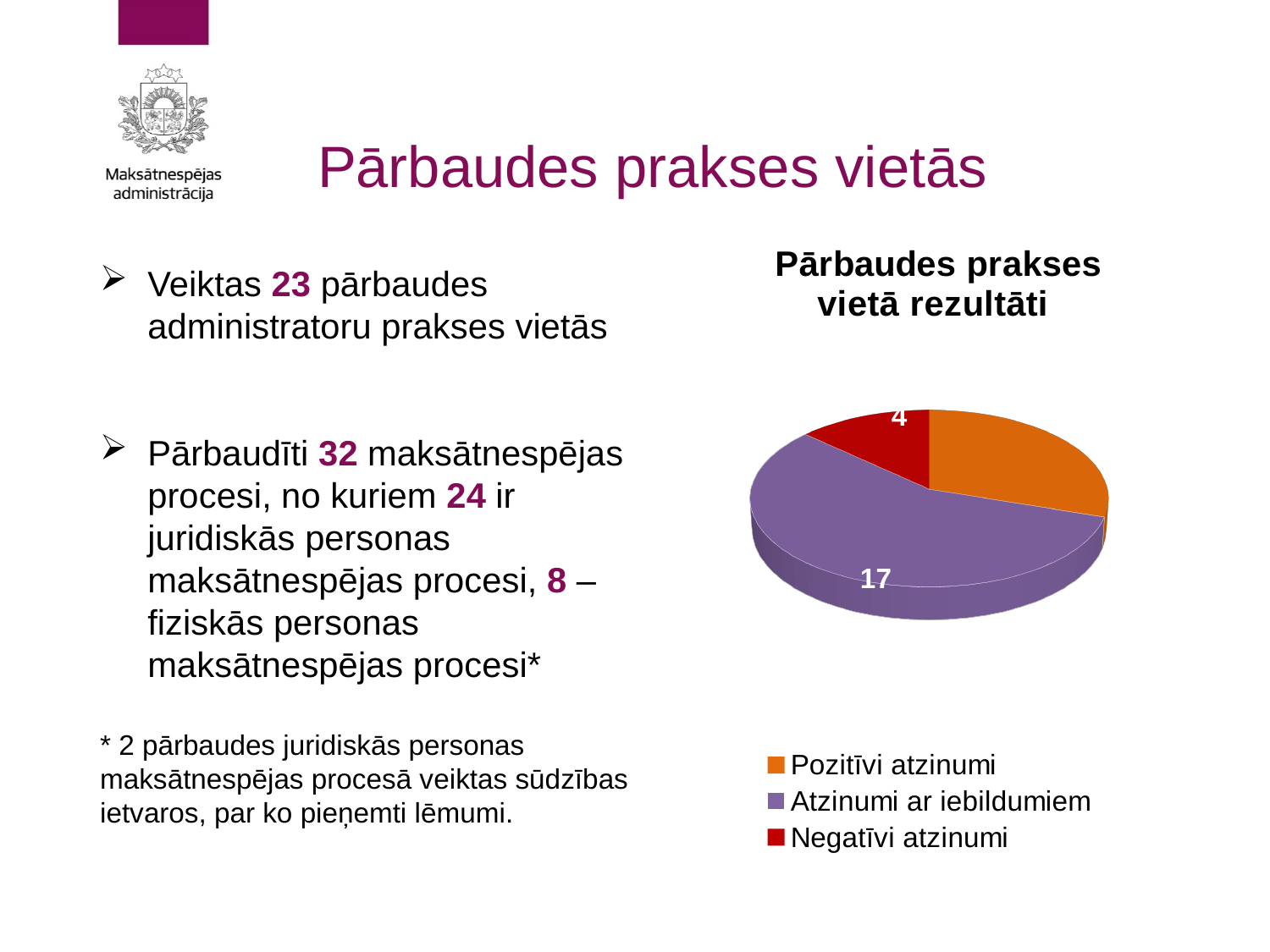
Which category has the smallest slice of the pie? Negatīvi atzinumi How many categories does the pie chart have? 3 What kind of chart is shown on the slide? pie chart Which is larger, Atzinumi ar iebildumiem or Negatīvi atzinumi? Atzinumi ar iebildumiem What is the value for Negatīvi atzinumi? 4 What colour is the slice for Pozitīvi atzinumi? orange Which category has the largest slice of the pie? Atzinumi ar iebildumiem What is the difference between the values for Atzinumi ar iebildumiem and Negatīvi atzinumi? 13 How many entries does the legend list? 3 What is the title of the chart? Pārbaudes prakses vietā rezultāti What is the value for Atzinumi ar iebildumiem? 17 Which is larger, Pozitīvi atzinumi or Negatīvi atzinumi? Pozitīvi atzinumi